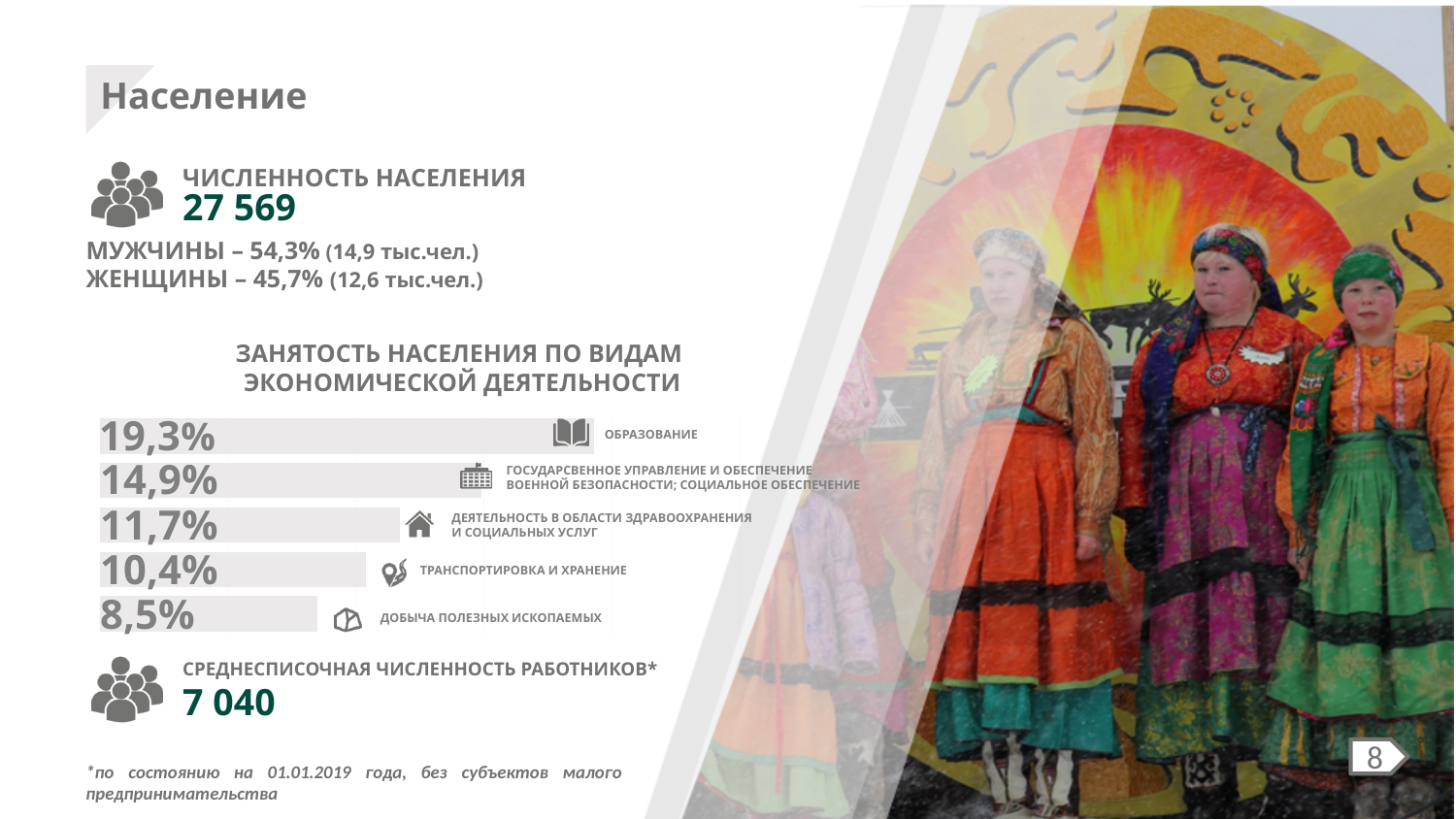
What is the title of the chart showing employment shares? Занятость населения по видам экономической деятельности What is the difference between the employment shares of Образование and Государственное управление и обеспечение военной безопасности; социальное обеспечение? 4,4% What is the share of employment in Деятельность в области здравоохранения и социальных услуг? 11,7% How many categories of economic activity are shown in the employment chart? 5 What is the difference between the employment shares of Образование and Добыча полезных ископаемых? 10,8% Which type of economic activity has the highest employment share? Образование What is the share of employment in Добыча полезных ископаемых? 8,5% Which has a larger employment share: Транспортировка и хранение or Деятельность в области здравоохранения и социальных услуг? Деятельность в области здравоохранения и социальных услуг What is the share of employment in Образование? 19,3% What type of chart is used to show employment by type of economic activity? bar chart What is the share of employment in Транспортировка и хранение? 10,4% Which type of economic activity has the lowest employment share? Добыча полезных ископаемых